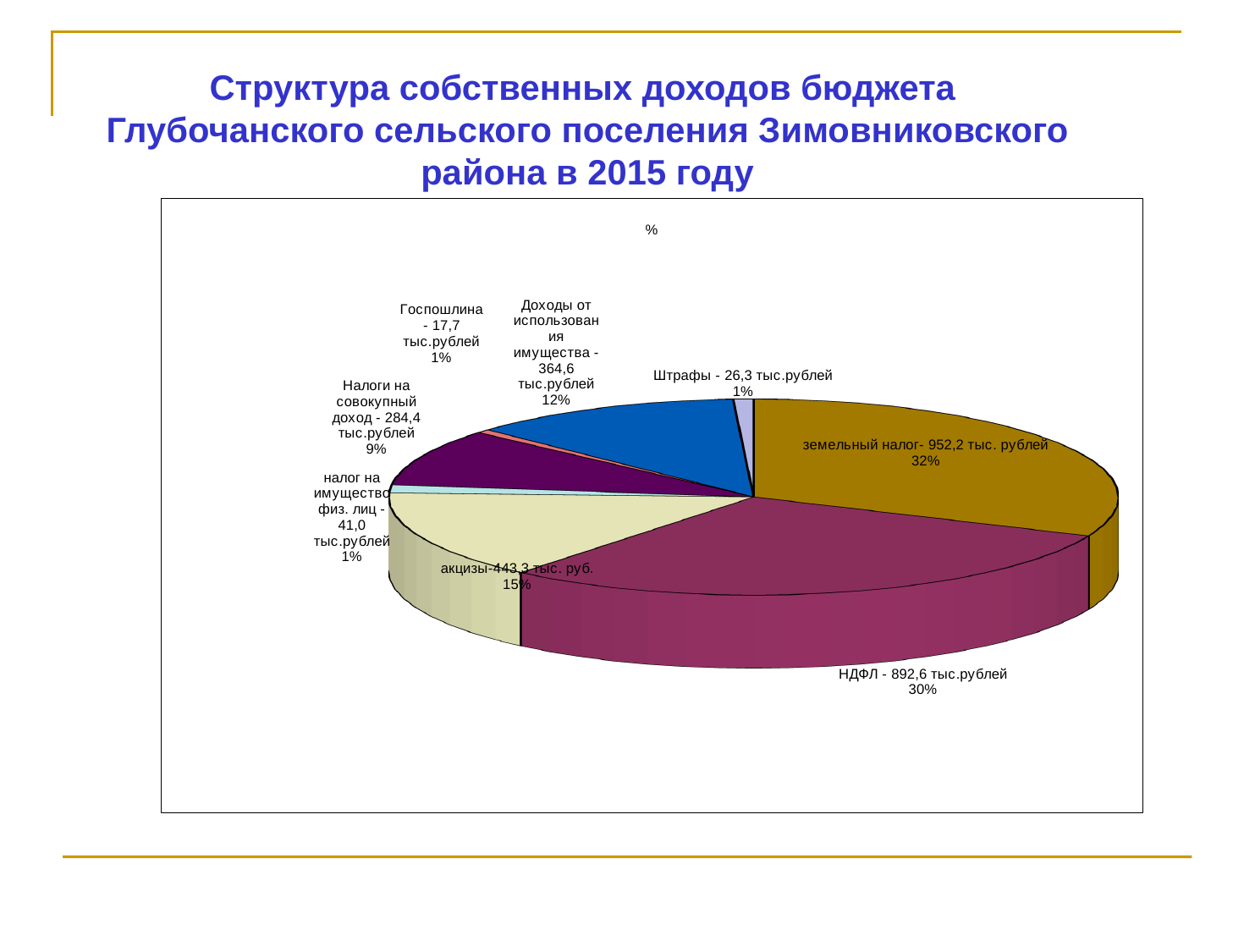
What is the value shown for акцизы? 443,3 тыс. руб. What share of the pie do Налоги на совокупный доход account for? 9% How many slices does the pie chart have? 8 What is the difference in value between земельный налог and НДФЛ? 59,6 тыс. рублей What is the value shown for Штрафы? 26,3 тыс.рублей Which category has the smallest value in the pie chart? Госпошлина Which category has the largest slice of the pie? земельный налог Which is larger, the value for акцизы or the value for Доходы от использования имущества? акцизы What kind of chart is shown on the slide? Pie chart What is the value shown for Доходы от использования имущества? 364,6 тыс.рублей What share of the pie does земельный налог account for? 32% What share of the pie does НДФЛ account for? 30%